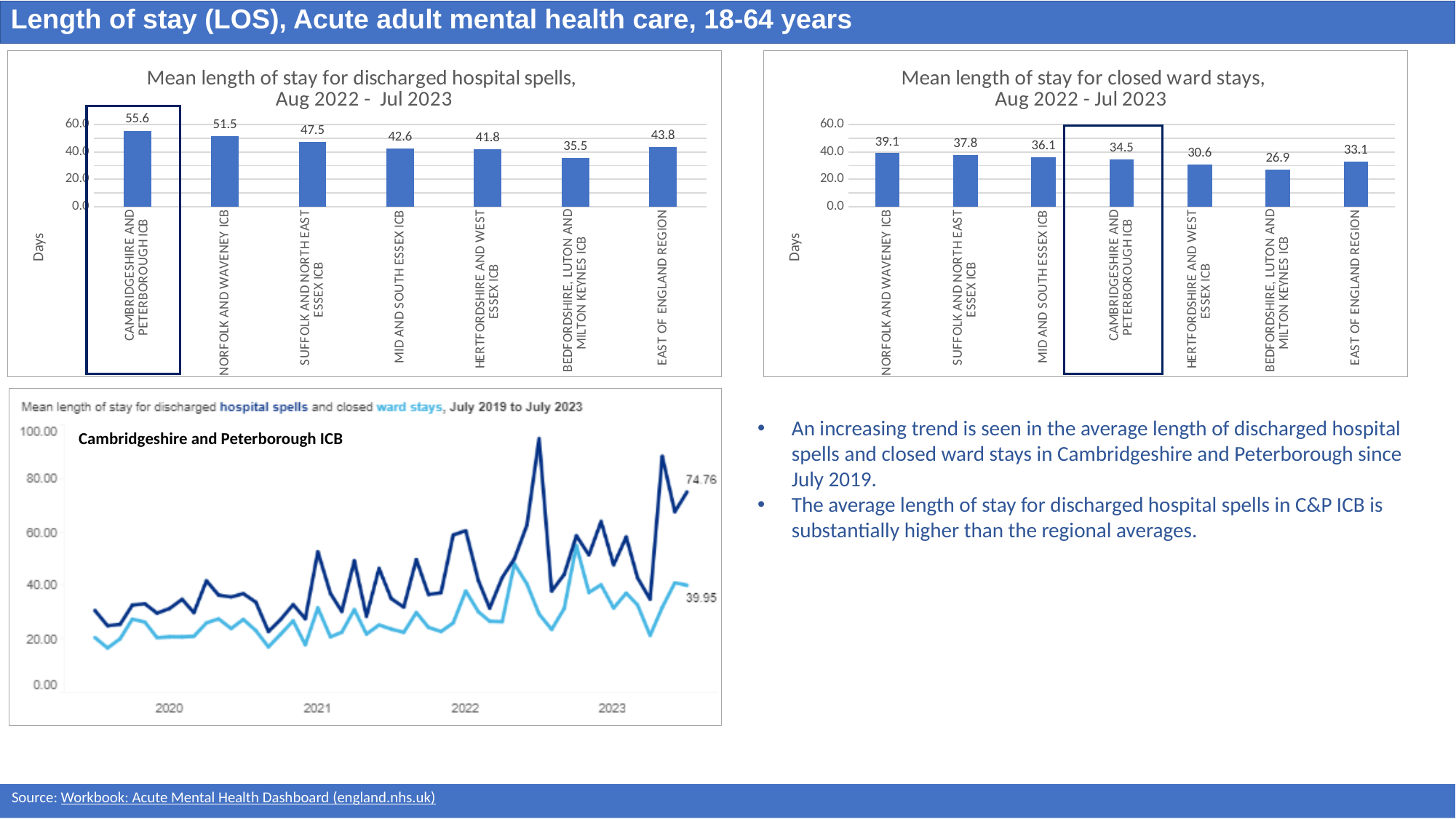
In the chart 'Mean length of stay for discharged hospital spells, Aug 2022 - Jul 2023', which category has the lowest value? Bedfordshire, Luton and Milton Keynes ICB In the chart 'Mean length of stay for discharged hospital spells, Aug 2022 - Jul 2023', what is the value for Cambridgeshire and Peterborough ICB? 55.6 In the chart 'Mean length of stay for closed ward stays, Aug 2022 - Jul 2023', which category has the highest value? Norfolk and Waveney ICB In the chart 'Mean length of stay for discharged hospital spells, Aug 2022 - Jul 2023', what is the difference between Cambridgeshire and Peterborough ICB and East of England Region? 11.8 What kind of chart is the bottom-left chart for Cambridgeshire and Peterborough ICB, July 2019 to July 2023? Line chart In the chart 'Mean length of stay for discharged hospital spells, Aug 2022 - Jul 2023', how many categories are shown? 7 In the chart 'Mean length of stay for closed ward stays, Aug 2022 - Jul 2023', what is the difference between Suffolk and North East Essex ICB and Hertfordshire and West Essex ICB? 7.2 In the bottom-left line chart for Cambridgeshire and Peterborough ICB, what is the final labelled value for hospital spells? 74.76 In the chart 'Mean length of stay for closed ward stays, Aug 2022 - Jul 2023', which is larger: Cambridgeshire and Peterborough ICB or East of England Region? Cambridgeshire and Peterborough ICB In the chart 'Mean length of stay for closed ward stays, Aug 2022 - Jul 2023', what is the value for Bedfordshire, Luton and Milton Keynes ICB? 26.9 In the chart 'Mean length of stay for closed ward stays, Aug 2022 - Jul 2023', what is the value for Norfolk and Waveney ICB? 39.1 In the bottom-left line chart for Cambridgeshire and Peterborough ICB, how many series are plotted? 2